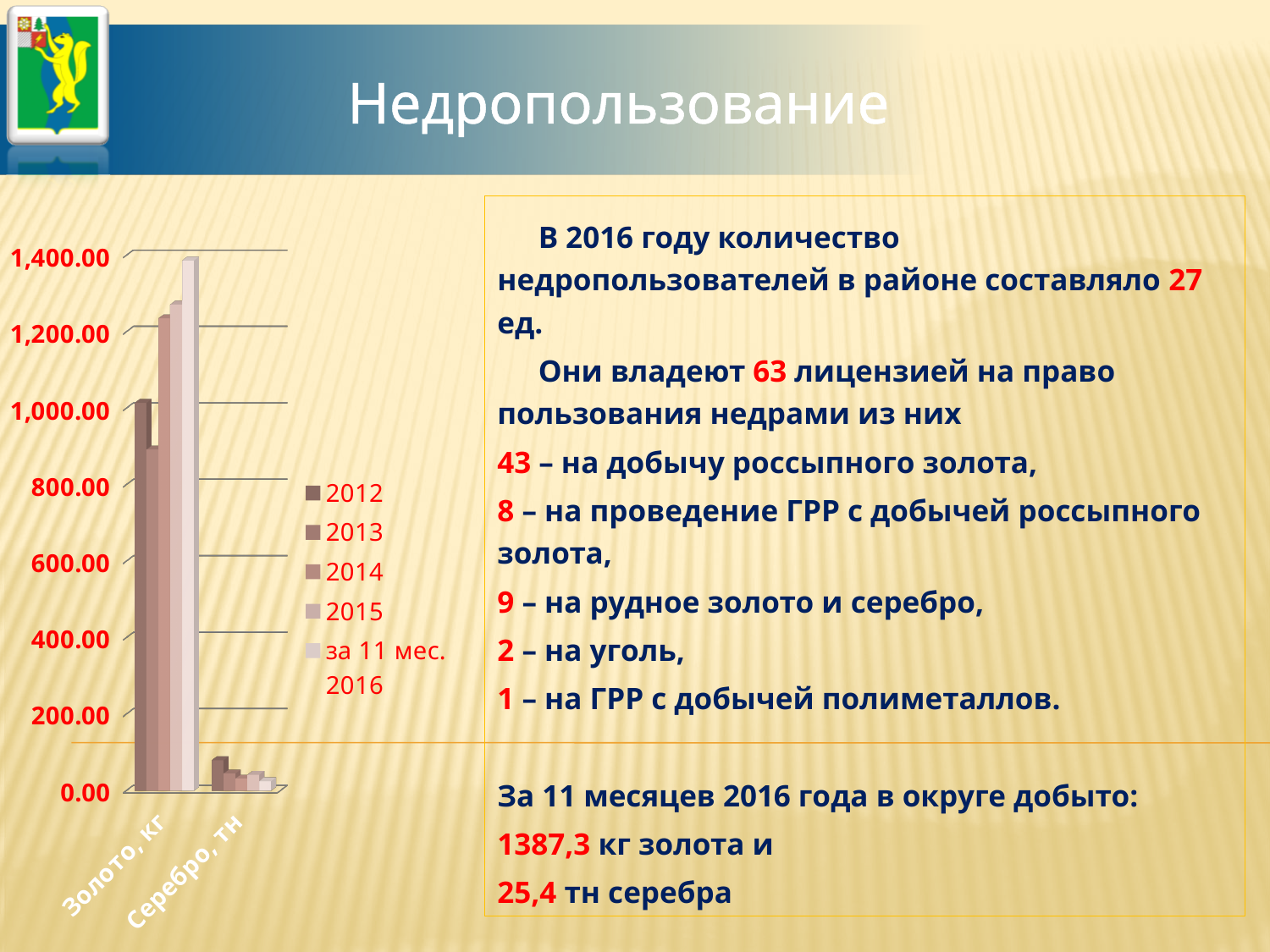
Which series has the tallest bar for the category 'Золото, кг'? за 11 мес. 2016 Is the value for 'Золото, кг' for 'за 11 мес. 2016' greater or less than 1,400.00? less Is the value for 'Золото, кг' in 2013 greater or less than 1,000.00? less Which series has the shortest bar for the category 'Золото, кг'? 2013 For 'Золото, кг', which is larger: the 2012 value or the 2013 value? 2012 How many series does the chart legend list? 5 Is the value for 'Золото, кг' in 2014 greater or less than 1,200.00? greater How many categories are shown on the x axis of the chart? 2 For the series 'за 11 мес. 2016', which category has the larger value: 'Золото, кг' or 'Серебро, тн'? Золото, кг What kind of chart is shown on the slide? bar chart What is the highest value shown on the chart's vertical axis? 1,400.00